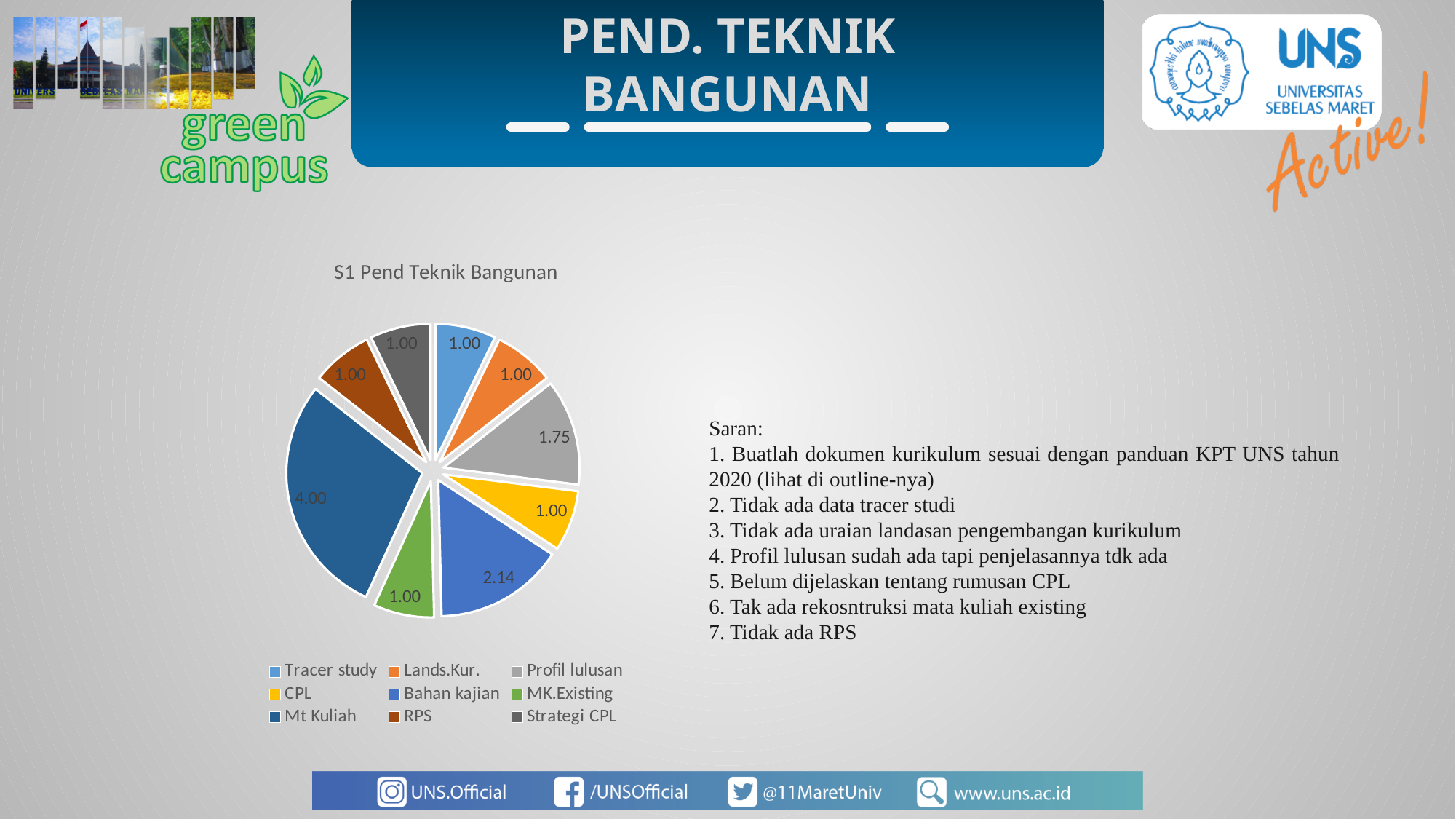
What is the value for Mt Kuliah? 4.00 What kind of chart is shown on the slide? Pie chart What is the title of the chart? S1 Pend Teknik Bangunan What is the value for Bahan kajian? 2.14 Which category has the largest slice in the pie chart? Mt Kuliah What is the total of all the slice values in the pie chart? 13.89 What is the difference between the values for Bahan kajian and Profil lulusan? 0.39 What is the value for Profil lulusan? 1.75 What is the difference between the values for Mt Kuliah and Bahan kajian? 1.86 Which is larger, the value for Profil lulusan or the value for Bahan kajian? Bahan kajian How many slices does the pie chart have? 9 How many slices in the pie chart have a value of 1.00? 6